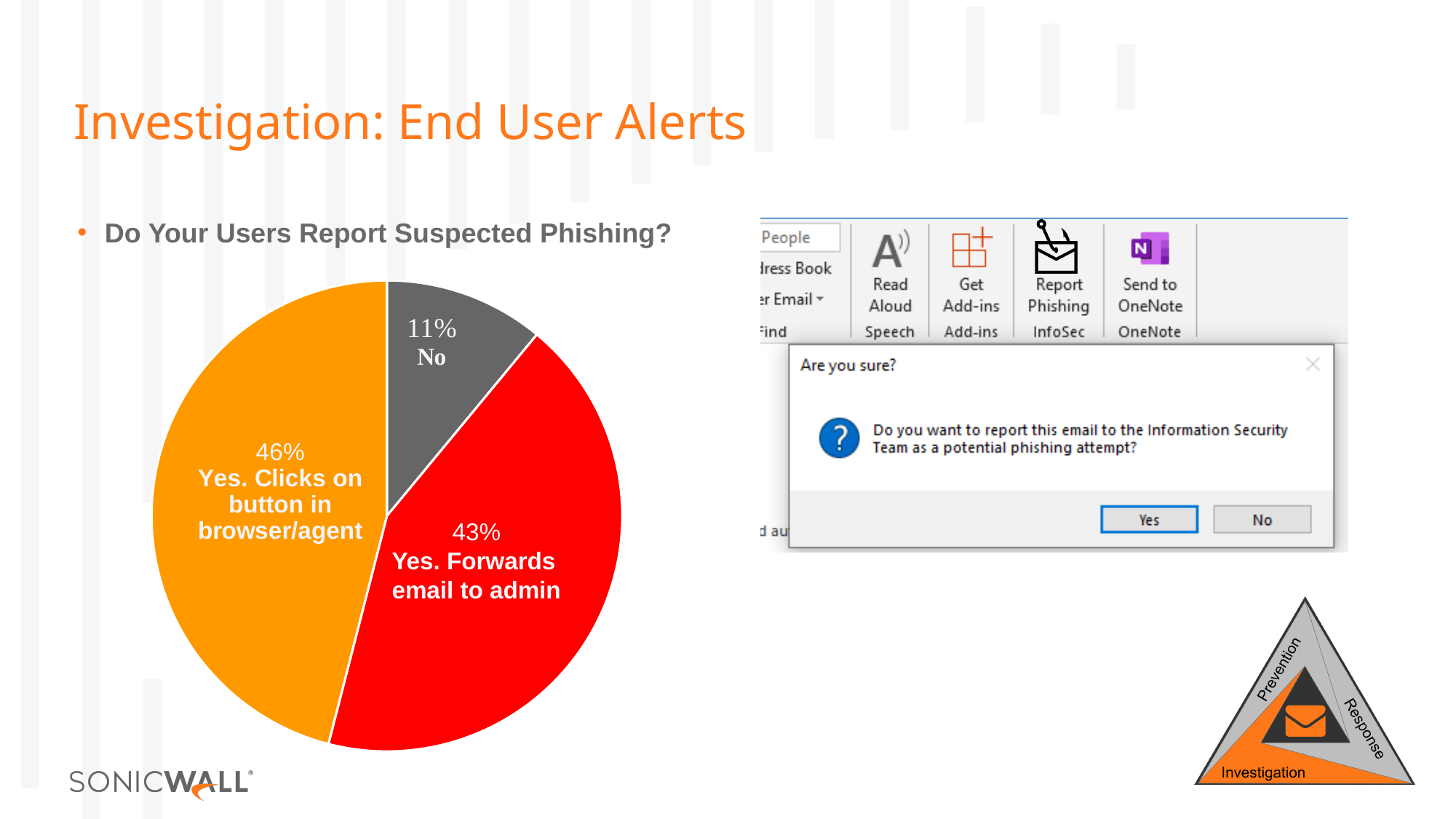
What kind of chart is shown on the slide? pie chart What percentage of the pie is labelled "No"? 11% What percentage of the pie is labelled "Yes. Clicks on button in browser/agent"? 46% How many slices does the pie chart have? 3 What is the difference in percentage points between the "Yes. Clicks on button in browser/agent" slice and the "Yes. Forwards email to admin" slice? 3 What colour is the "No" slice of the pie? grey Which is larger: the "Yes. Forwards email to admin" slice or the "No" slice? Yes. Forwards email to admin What is the difference in percentage points between the "Yes. Forwards email to admin" slice and the "No" slice? 32 What percentage of the pie is labelled "Yes. Forwards email to admin"? 43% Which slice of the pie is the smallest? No Which slice of the pie is the largest? Yes. Clicks on button in browser/agent What question does the pie chart answer, according to the bullet text above it? Do Your Users Report Suspected Phishing?